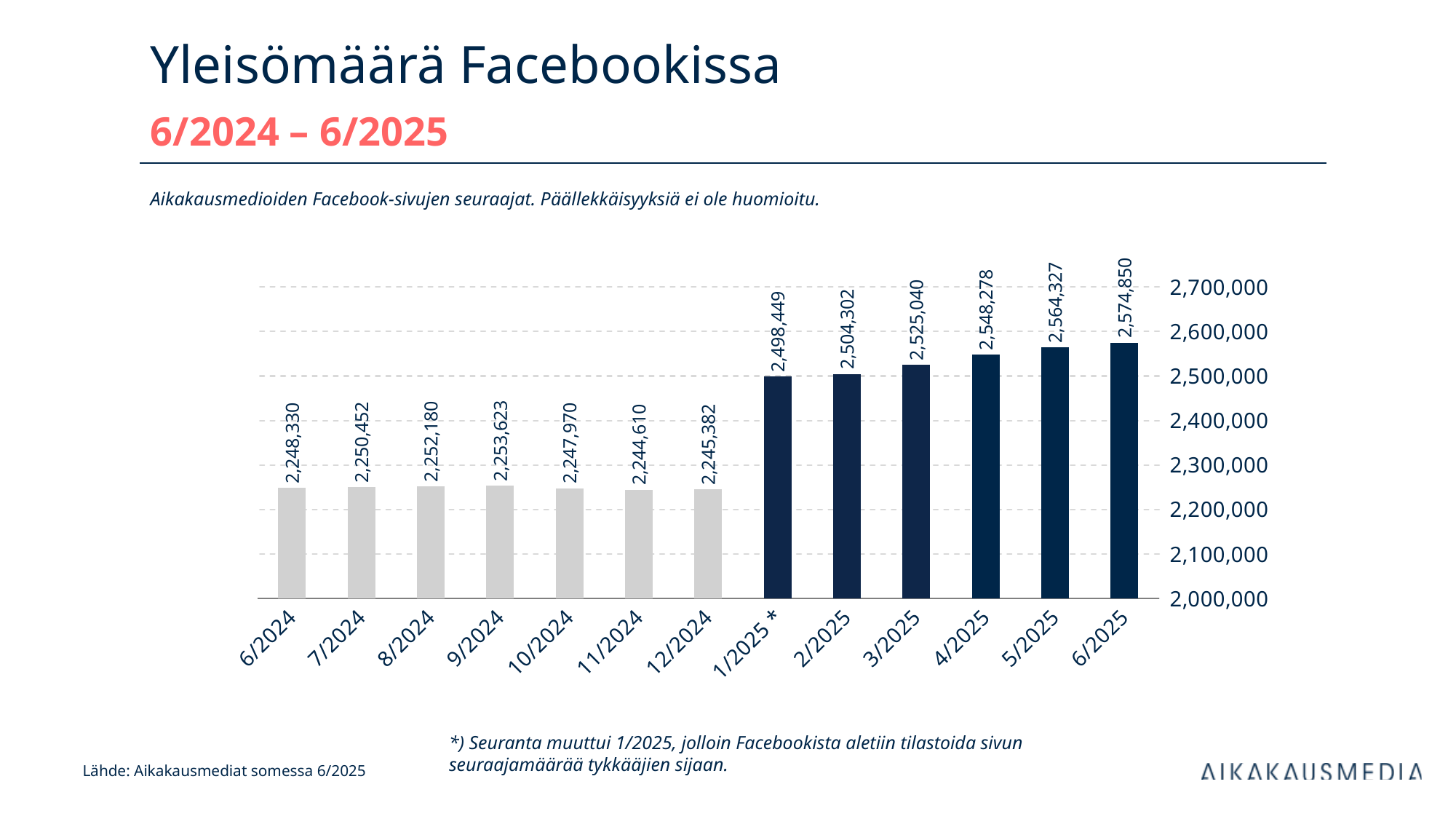
Which is larger, the value for 4/2025 or the value for 2/2025? 4/2025 What kind of chart is shown on the slide? bar chart How many months are shown on the x axis? 13 Is the value for 3/2025 greater or less than 2,500,000? greater Do the values generally rise or fall from 6/2024 to 6/2025? rise What is the value for 6/2025? 2,574,850 Which month has the highest value? 6/2025 What is the difference between the values for 1/2025 * and 12/2024? 253,067 What is the value for 1/2025 *? 2,498,449 What is the difference between the values for 6/2025 and 6/2024? 326,520 What is the value for 9/2024? 2,253,623 Which month has the lowest value? 11/2024